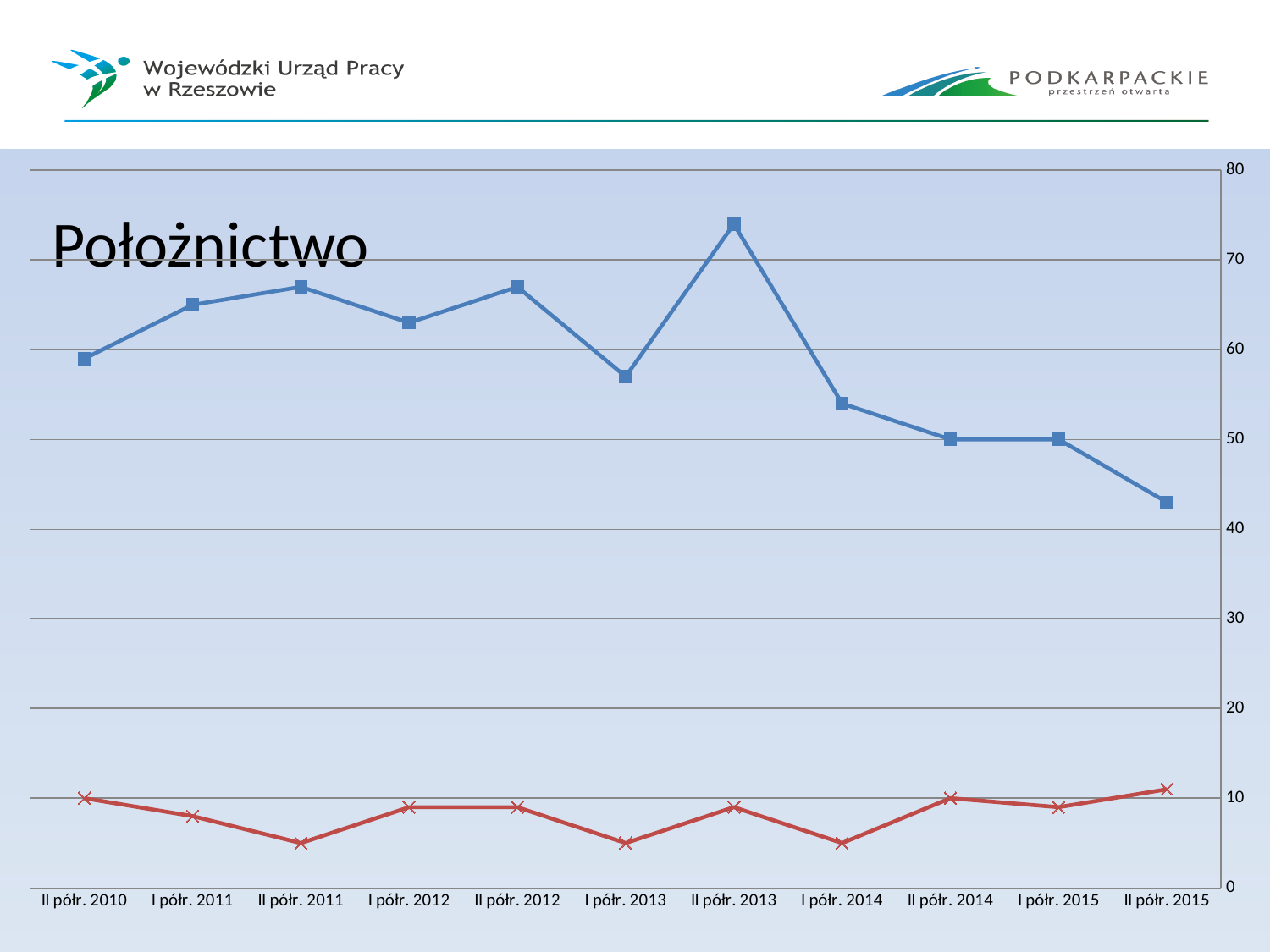
What kind of chart is shown on the slide? line chart What is the first period shown on the x axis? II półr. 2010 Which is larger for the blue series: the value for I półr. 2011 or the value for I półr. 2013? I półr. 2011 In which period does the blue series reach its lowest value? II półr. 2015 Is the value of the red series for II półr. 2011 greater or less than 10? less Is the value of the blue series for II półr. 2013 greater or less than 70? greater In which period does the blue series reach its highest value? II półr. 2013 How many periods are plotted along the x axis? 11 How many data series are plotted on the chart? 2 What is the title of the chart? Położnictwo Is the value of the blue series for II półr. 2015 greater or less than 50? less Does the blue series rise or fall from II półr. 2013 to II półr. 2015? fall